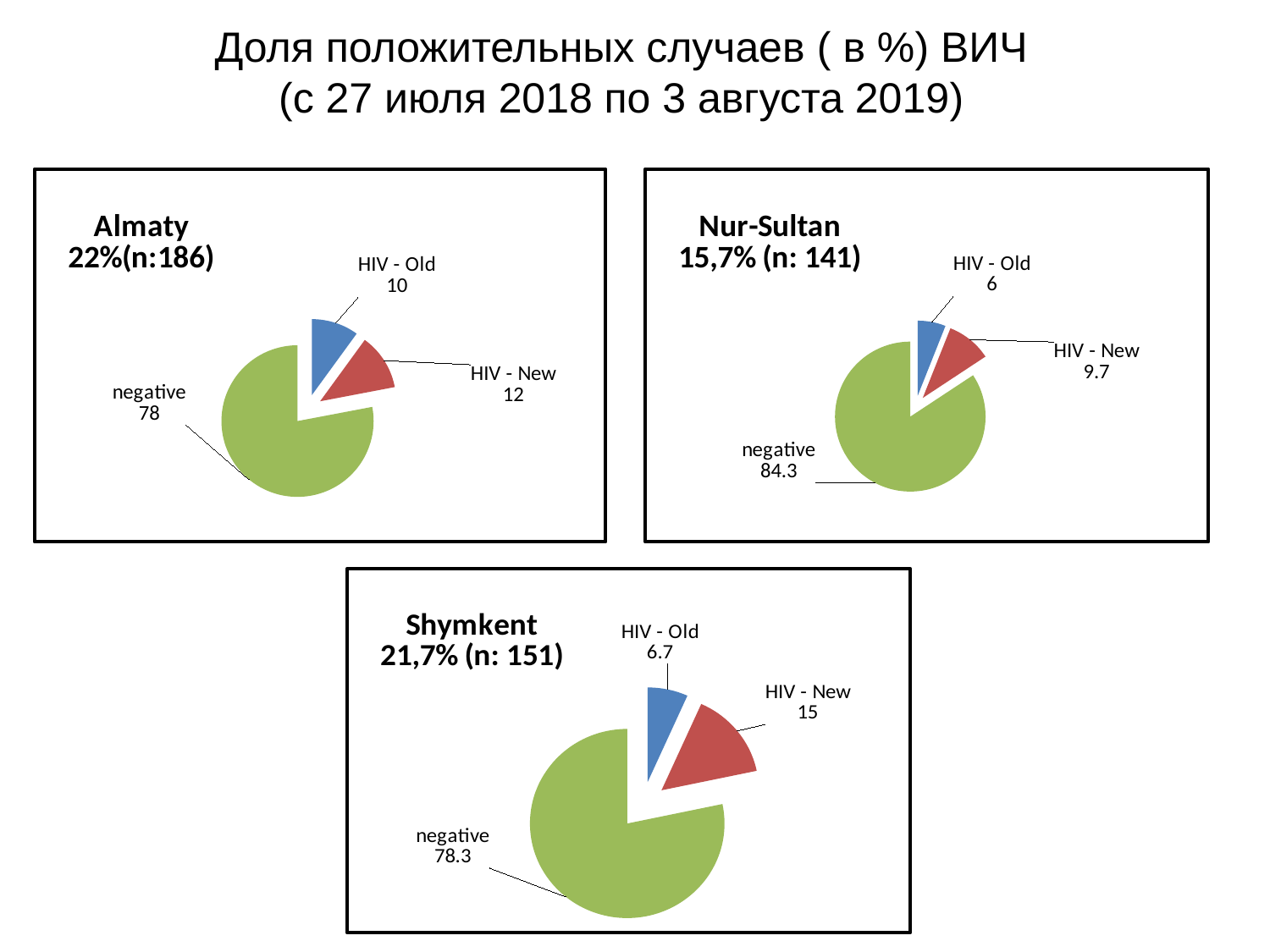
How many pie charts are shown on the slide? 3 In the Shymkent pie chart, which slice is the largest? negative In the Shymkent pie chart, what is the value for HIV - Old? 6.7 In the Almaty pie chart, which slice is the smallest? HIV - Old In the Shymkent pie chart, which is larger, HIV - New or HIV - Old? HIV - New In the Nur-Sultan pie chart, what is the value for HIV - New? 9.7 In the Almaty pie chart, what is the difference between HIV - New and HIV - Old? 2 How many slices does the Nur-Sultan pie chart have? 3 In the Nur-Sultan pie chart, what is the value for negative? 84.3 In the Almaty pie chart, what is the value for negative? 78 What type of chart is used for Almaty? Pie chart What is the sample size (n) shown for the Shymkent chart? 151